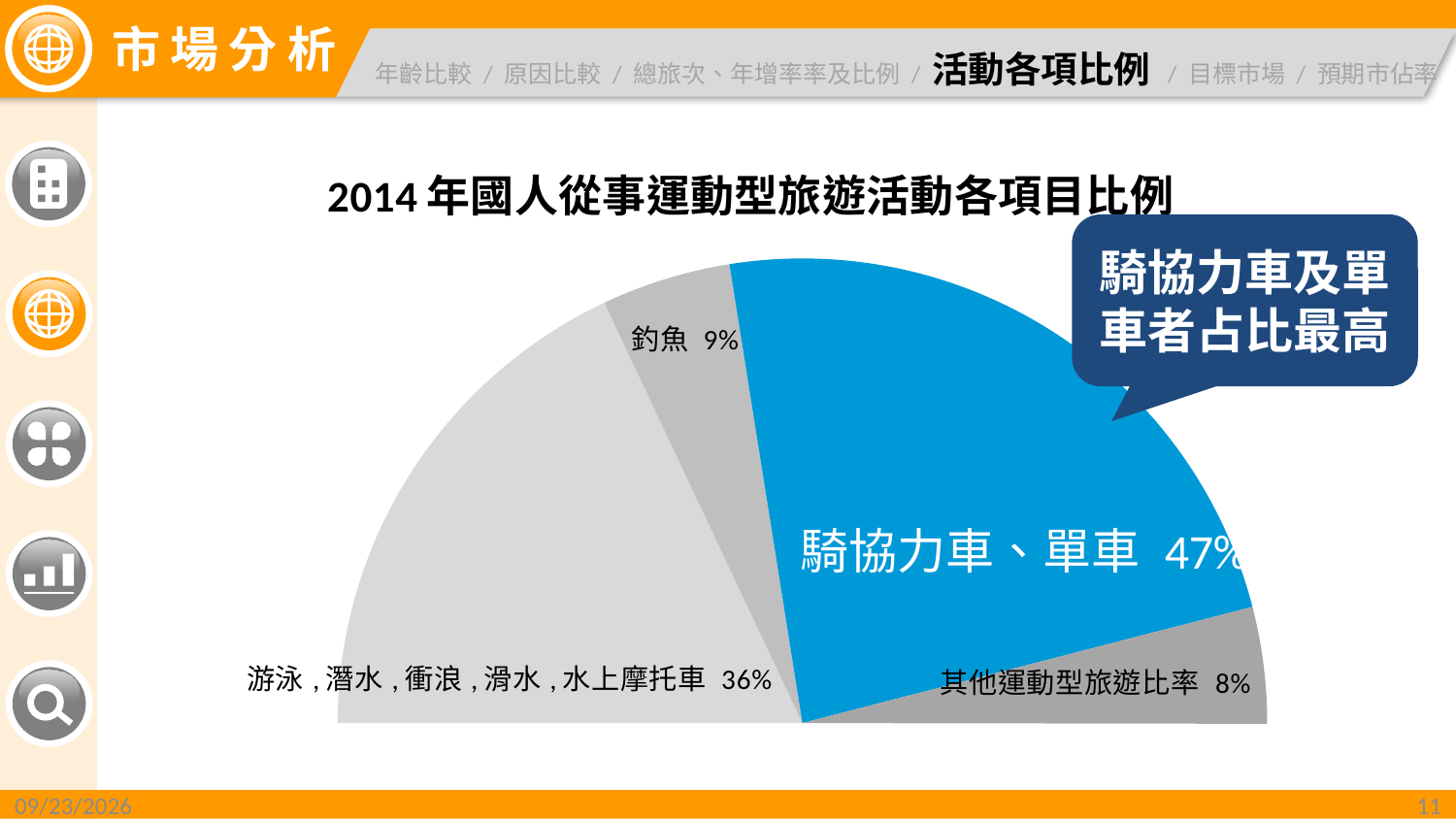
Which category has the largest share in the chart? 騎協力車、單車 Which has a larger share, 釣魚 or 游泳,潛水,衝浪,滑水,水上摩托車? 游泳,潛水,衝浪,滑水,水上摩托車 What is the title of the chart? 2014 年國人從事運動型旅遊活動各項目比例 What is the percentage shown for 騎協力車、單車? 47% What is the percentage shown for 其他運動型旅遊比率? 8% What is the percentage shown for 釣魚? 9% How many categories are shown in the chart? 4 What kind of chart is shown on the slide? Pie chart What is the difference in percentage points between 釣魚 and 其他運動型旅遊比率? 1 Which category has the smallest share in the chart? 其他運動型旅遊比率 What is the percentage shown for 游泳,潛水,衝浪,滑水,水上摩托車? 36% What is the difference in percentage points between 騎協力車、單車 and 游泳,潛水,衝浪,滑水,水上摩托車? 11